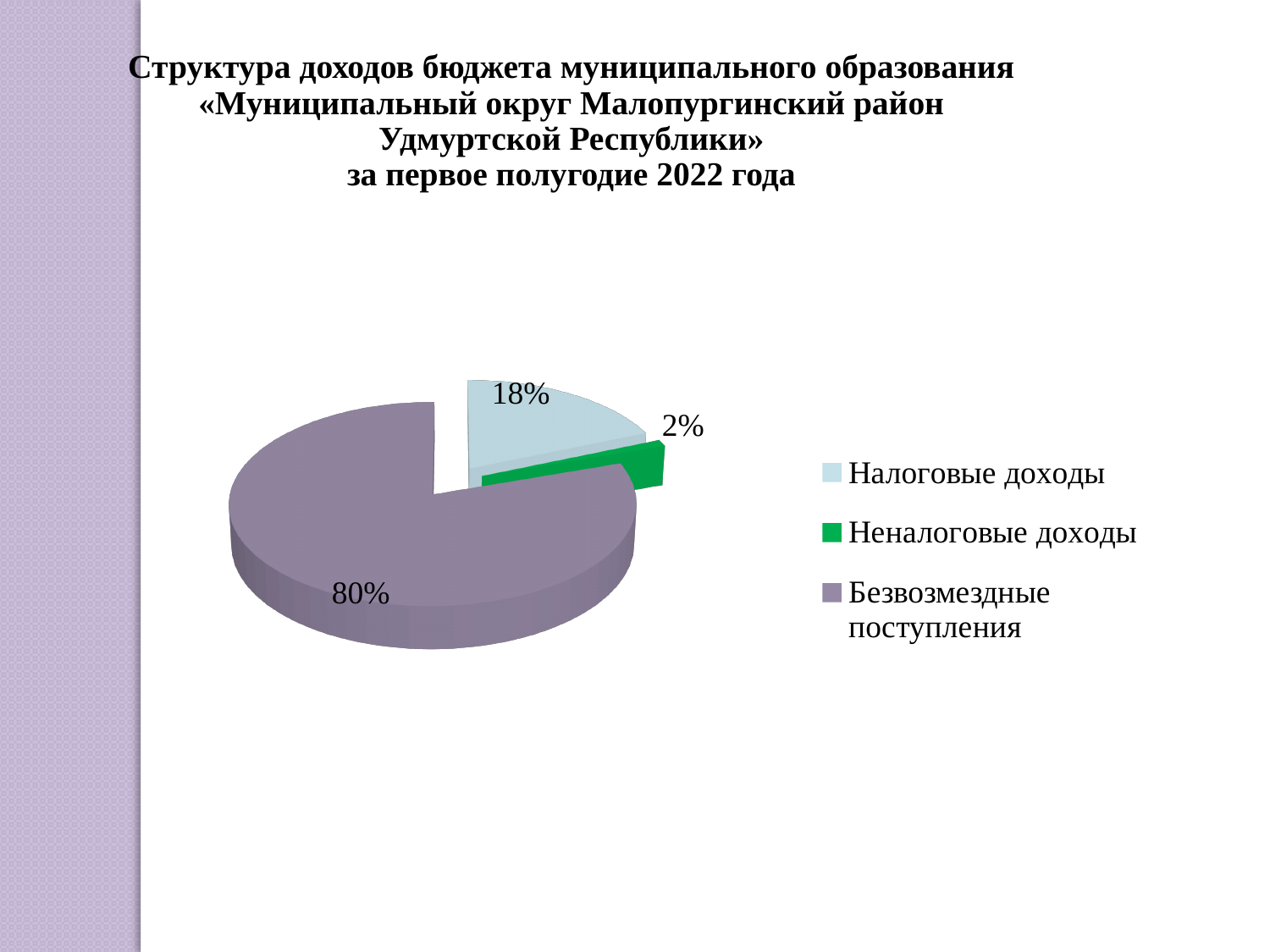
What is the difference in percentage points between Налоговые доходы and Неналоговые доходы? 16 What share of the pie does Безвозмездные поступления represent? 80% What share of the pie does Неналоговые доходы represent? 2% Which category has the smallest slice of the pie? Неналоговые доходы What colour is the slice for Неналоговые доходы? green What kind of chart is shown on the slide? pie chart What share of the pie does Налоговые доходы represent? 18% What is the difference in percentage points between Безвозмездные поступления and Налоговые доходы? 62 Which is larger, Налоговые доходы or Неналоговые доходы? Налоговые доходы Which category has the largest slice of the pie? Безвозмездные поступления How many slices does the pie chart have? 3 Which legend entry is shown in light blue? Налоговые доходы